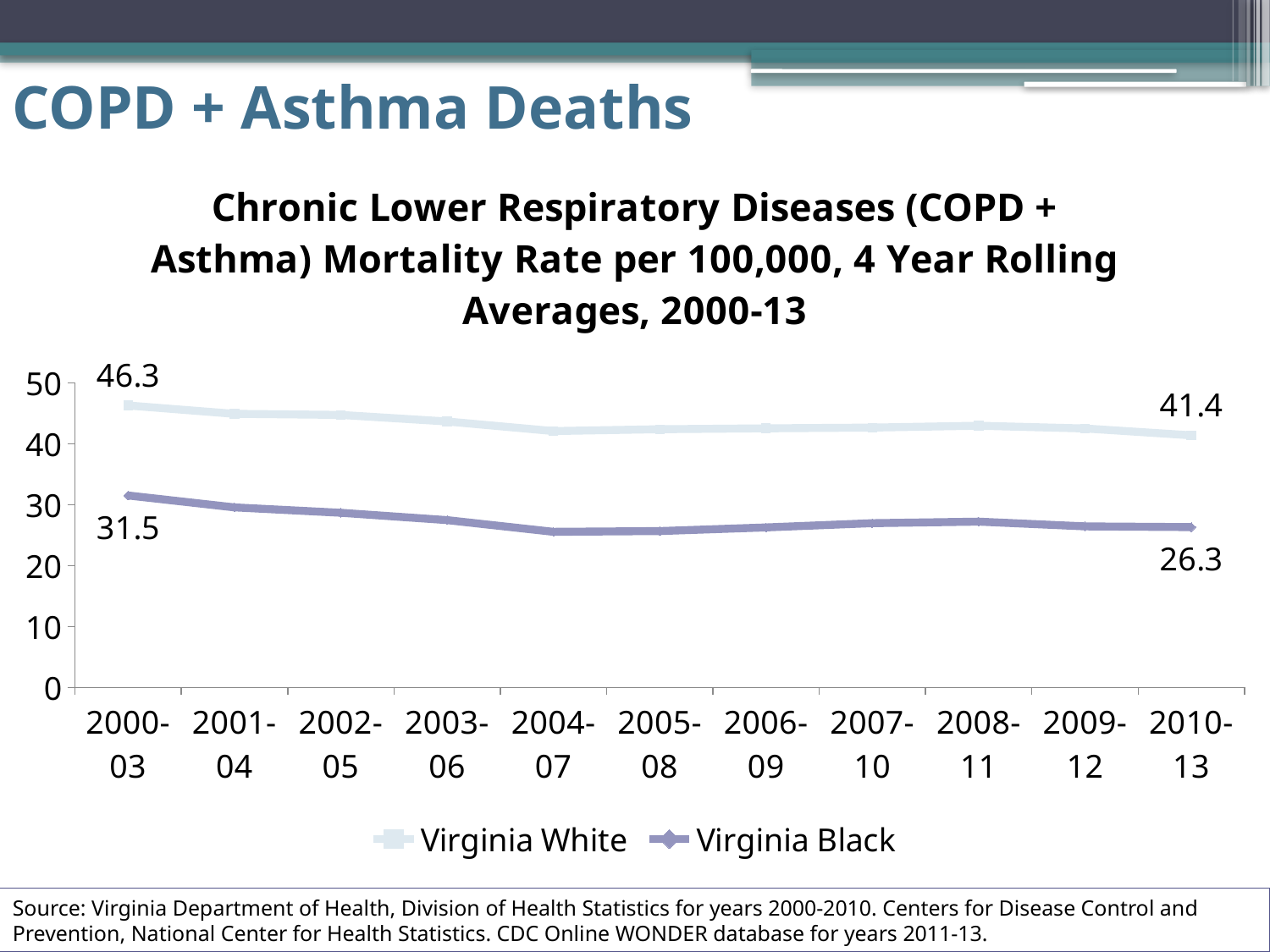
What is the Virginia Black mortality rate for 2010-13? 26.3 What is the Virginia White mortality rate for 2010-13? 41.4 Which series has the higher rate in 2005-08, Virginia White or Virginia Black? Virginia White Is the Virginia Black value for 2004-07 greater or less than 30? less What is the Virginia Black mortality rate for 2000-03? 31.5 By how much did the Virginia White rate change from 2000-03 to 2010-13? 4.9 How many time periods are shown on the x axis? 11 What kind of chart is shown on the slide? line chart How many series does the legend list? 2 What is the Virginia White mortality rate for 2000-03? 46.3 Is the Virginia White value for 2008-11 greater or less than 40? greater What is the difference between the Virginia White and Virginia Black rates for 2000-03? 14.8